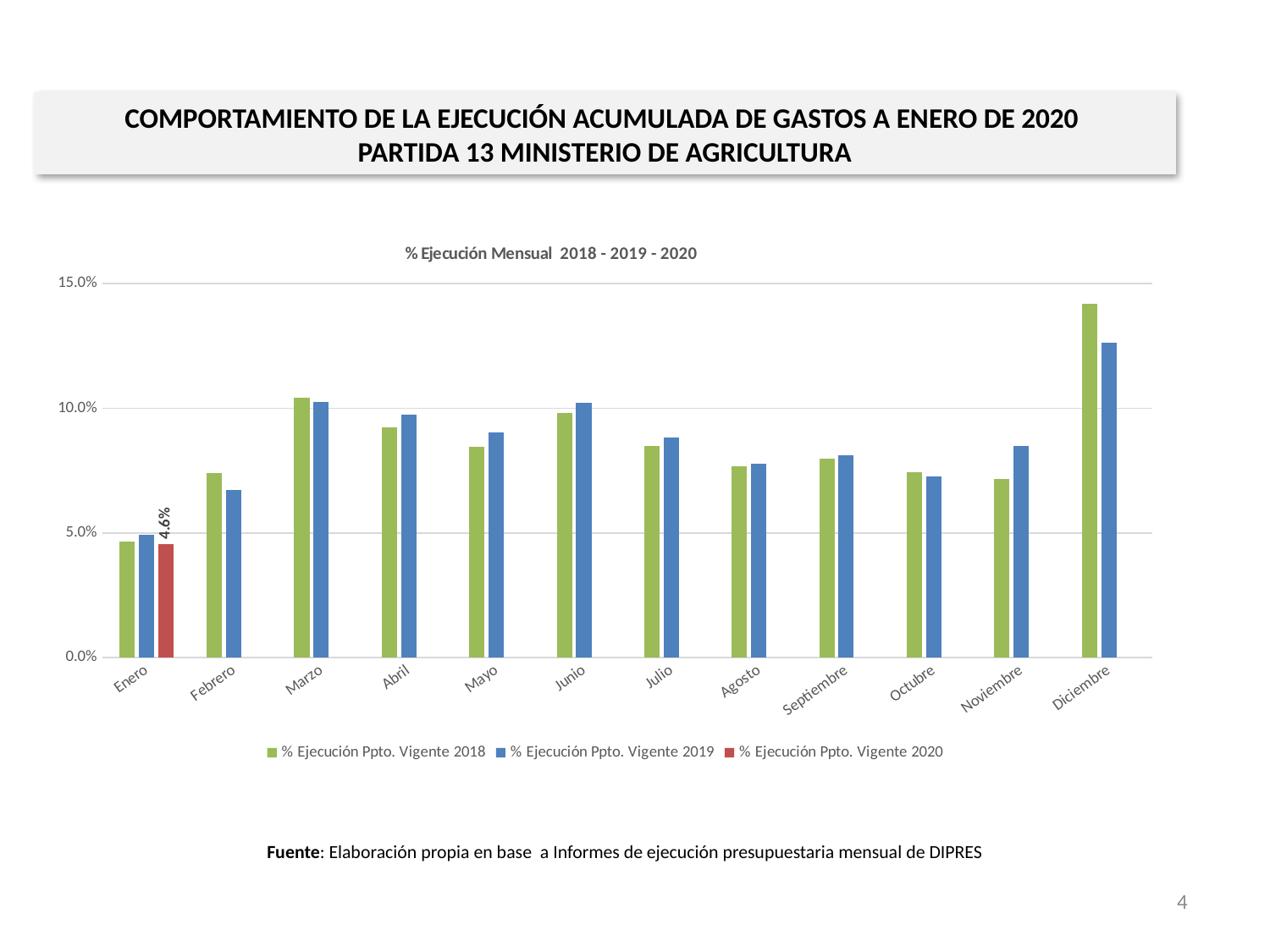
Which month has the lowest value for % Ejecución Ppto. Vigente 2018? Enero What kind of chart is shown on the slide? Bar chart Is the value for % Ejecución Ppto. Vigente 2019 in Febrero greater or less than 5.0%? greater Which month has the highest value for % Ejecución Ppto. Vigente 2019? Diciembre Which is larger for % Ejecución Ppto. Vigente 2018: Marzo or Febrero? Marzo What is the value for % Ejecución Ppto. Vigente 2020 in Enero? 4.6% Which month has the highest value for % Ejecución Ppto. Vigente 2018? Diciembre Is the value for % Ejecución Ppto. Vigente 2018 in Diciembre greater or less than 10.0%? greater How many series does the legend list? 3 In Noviembre, which series has the larger value: % Ejecución Ppto. Vigente 2018 or % Ejecución Ppto. Vigente 2019? % Ejecución Ppto. Vigente 2019 How many months are shown on the x axis of the chart? 12 What is the title of the chart? % Ejecución Mensual 2018 - 2019 - 2020